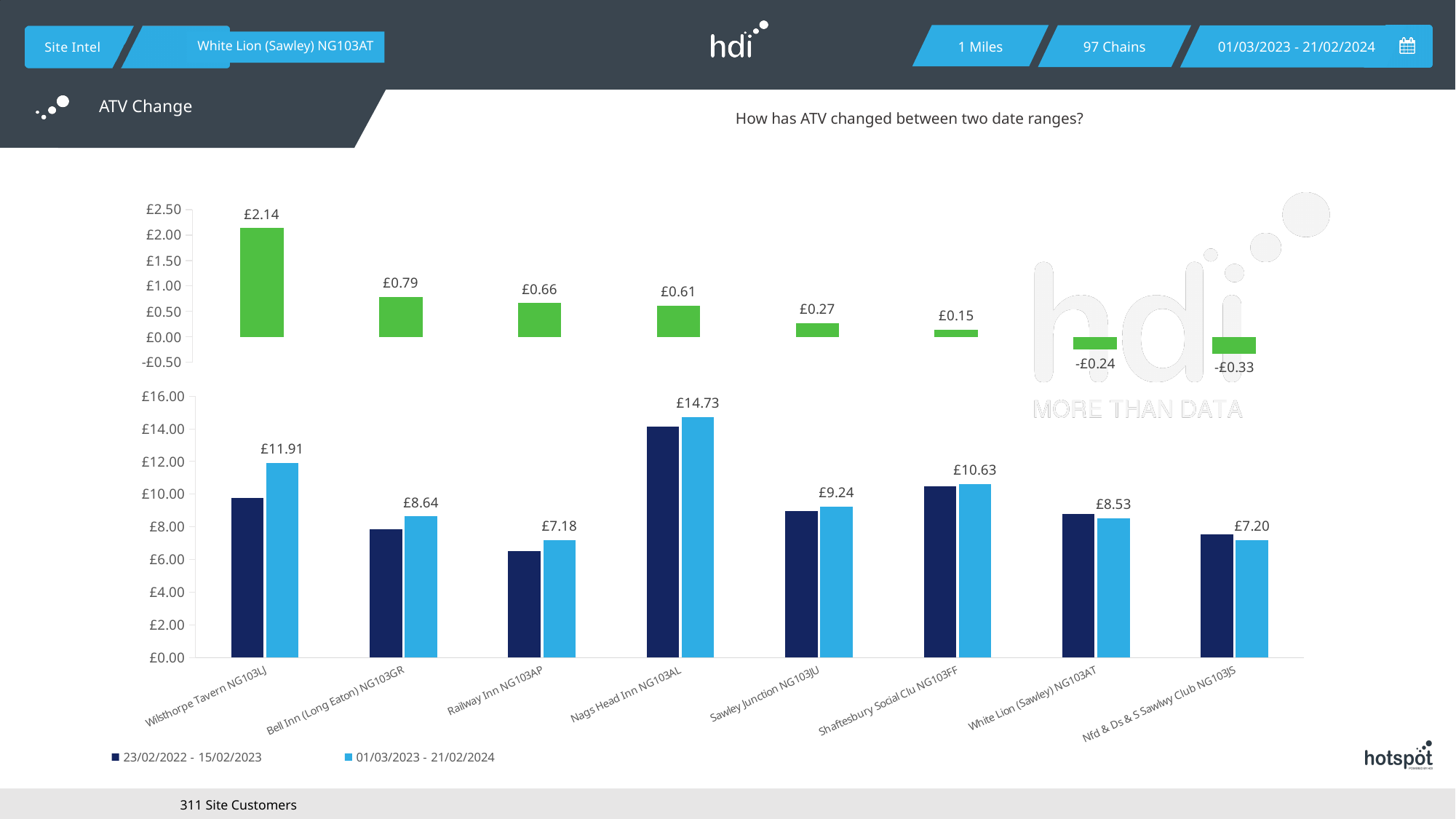
In the top chart (ATV change), which site has the lowest value? Nfd & Ds & S Sawlwy Club NG103JS In the top chart (ATV change), what is the value for Wilsthorpe Tavern NG103LJ? £2.14 What kind of chart is the bottom chart? bar chart In the bottom chart, is the value for Railway Inn NG103AP in the 23/02/2022 - 15/02/2023 series greater or less than £8.00? less In the top chart (ATV change), what is the difference between the values for Bell Inn (Long Eaton) NG103GR and Railway Inn NG103AP? £0.13 In the top chart (ATV change), which site has the highest value? Wilsthorpe Tavern NG103LJ How many series does the legend of the bottom chart list? 2 In the bottom chart, what is the value for Nags Head Inn NG103AL in the 01/03/2023 - 21/02/2024 series? £14.73 How many sites are shown on the x axis of the bottom chart? 8 In the bottom chart, what is the value for Nfd & Ds & S Sawlwy Club NG103JS in the 01/03/2023 - 21/02/2024 series? £7.20 In the top chart (ATV change), what is the value for White Lion (Sawley) NG103AT? -£0.24 In the bottom chart, which is larger in the 01/03/2023 - 21/02/2024 series: Sawley Junction NG103JU or Shaftesbury Social Clu NG103FF? Shaftesbury Social Clu NG103FF